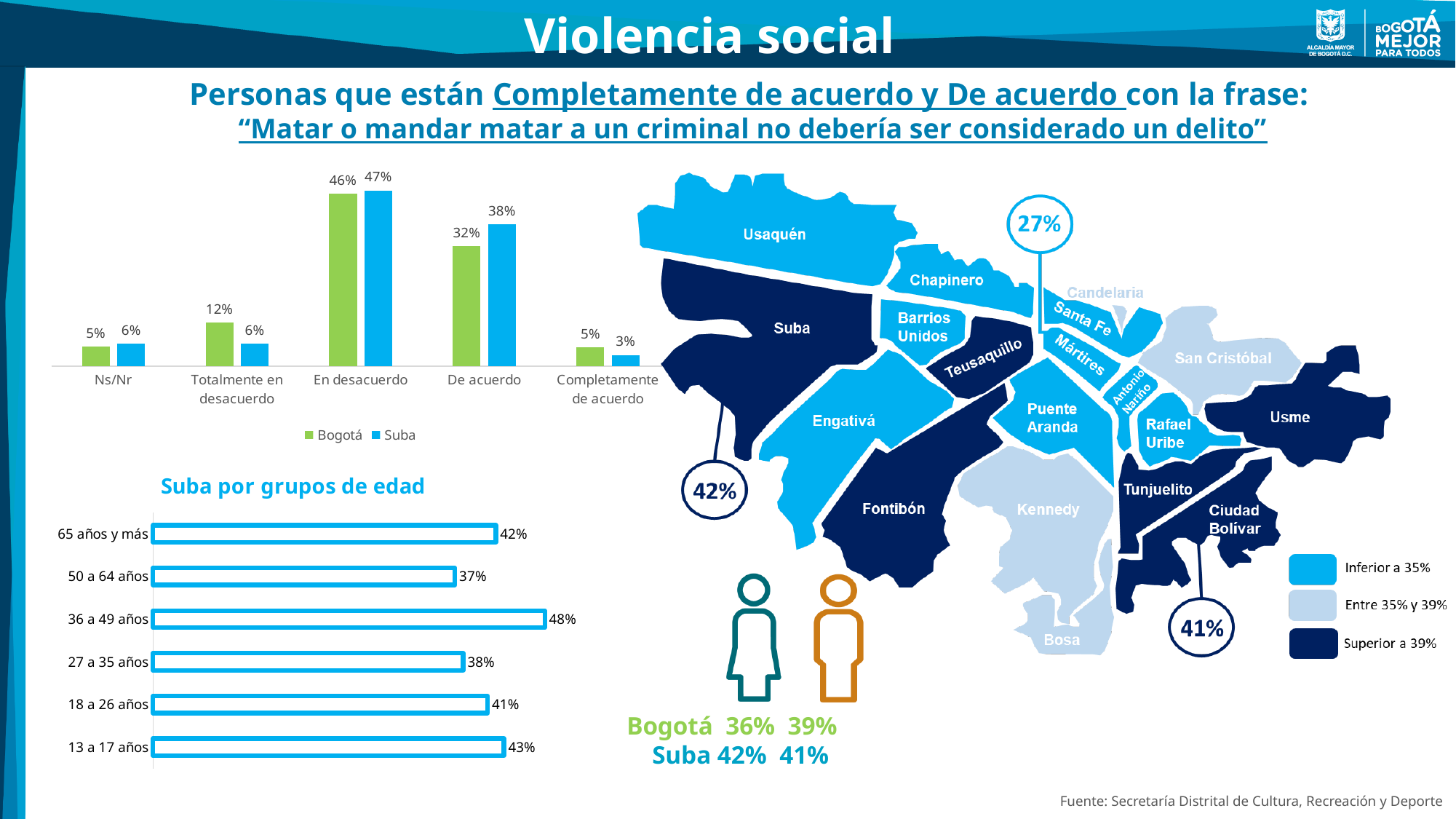
How many categories are shown on the x axis of the top-left bar chart comparing Bogotá and Suba? 5 In the top-left bar chart comparing Bogotá and Suba, which is larger for 'Completamente de acuerdo': Bogotá or Suba? Bogotá In the top-left bar chart comparing Bogotá and Suba, what is the value for Suba in the 'De acuerdo' category? 38% What kind of chart is 'Suba por grupos de edad'? Bar chart In the top-left bar chart comparing Bogotá and Suba, what is the value for Bogotá in the 'En desacuerdo' category? 46% In the top-left bar chart comparing Bogotá and Suba, which category has the highest value for Suba? En desacuerdo In the chart 'Suba por grupos de edad', what is the value for '36 a 49 años'? 48% How many age groups are shown in the chart 'Suba por grupos de edad'? 6 In the top-left bar chart comparing Bogotá and Suba, what is the difference between the Suba and Bogotá values for 'De acuerdo'? 6% In the chart 'Suba por grupos de edad', what is the difference between the values for '65 años y más' and '50 a 64 años'? 5% In the chart 'Suba por grupos de edad', which age group has the lowest value? 50 a 64 años How many series does the legend of the top-left bar chart list? 2